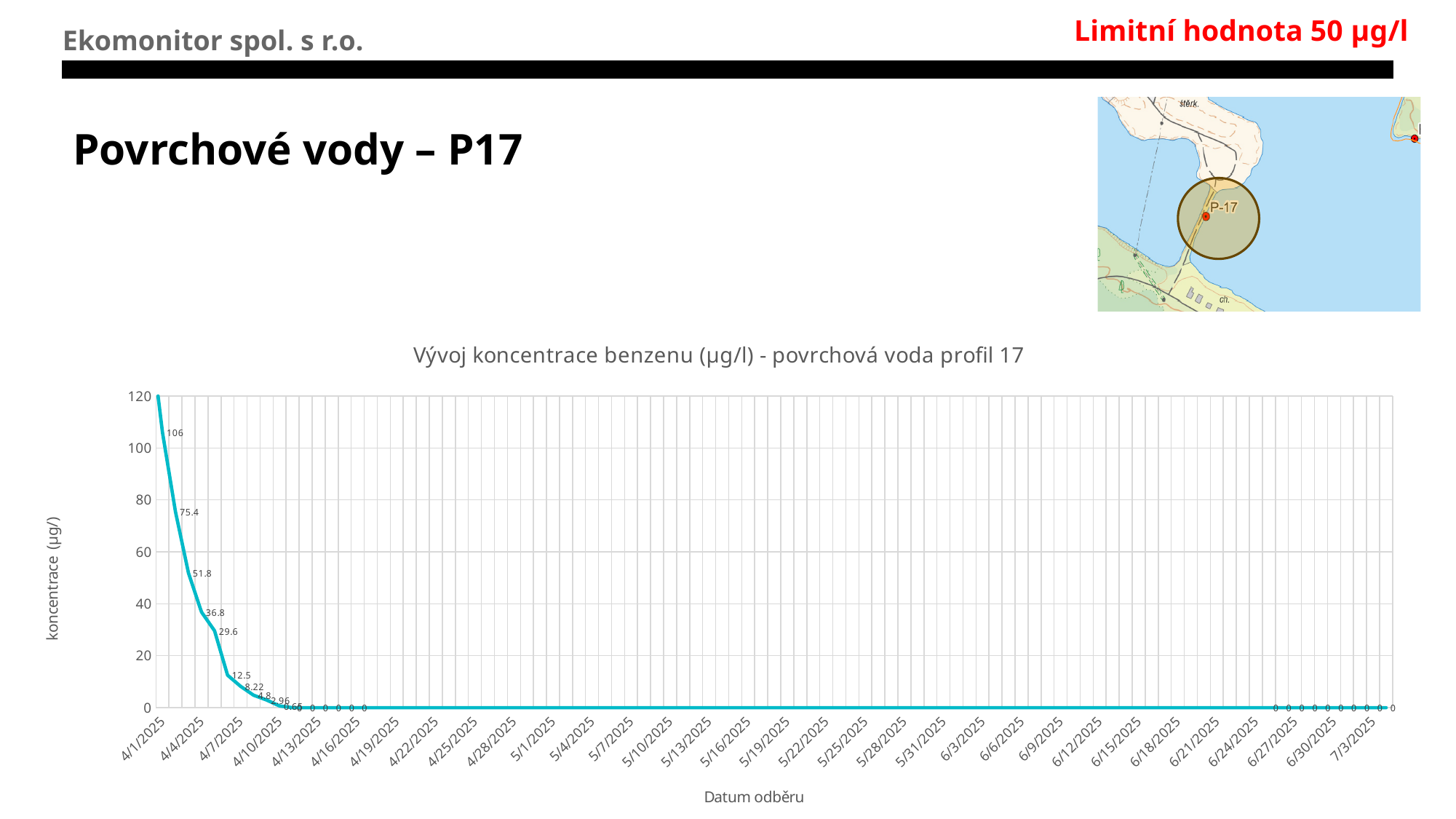
On which date is the benzene concentration highest? 4/1/2025 What is the benzene concentration on 4/7/2025? 8.22 What is the benzene concentration on 7/3/2025? 0 What is the title of the chart? Vývoj koncentrace benzenu (µg/l) - povrchová voda profil 17 What is the difference between the concentration on 4/4/2025 and on 4/7/2025? 28.58 Is the concentration on 4/1/2025 greater or less than 100? greater Which date has the higher concentration, 4/4/2025 or 4/10/2025? 4/4/2025 What is the benzene concentration on 4/10/2025? 0.65 Do the concentration values rise or fall over time along the x axis? fall What is the benzene concentration on 4/4/2025? 36.8 What is the label of the x axis of the chart? Datum odběru What kind of chart is shown on the slide? line chart